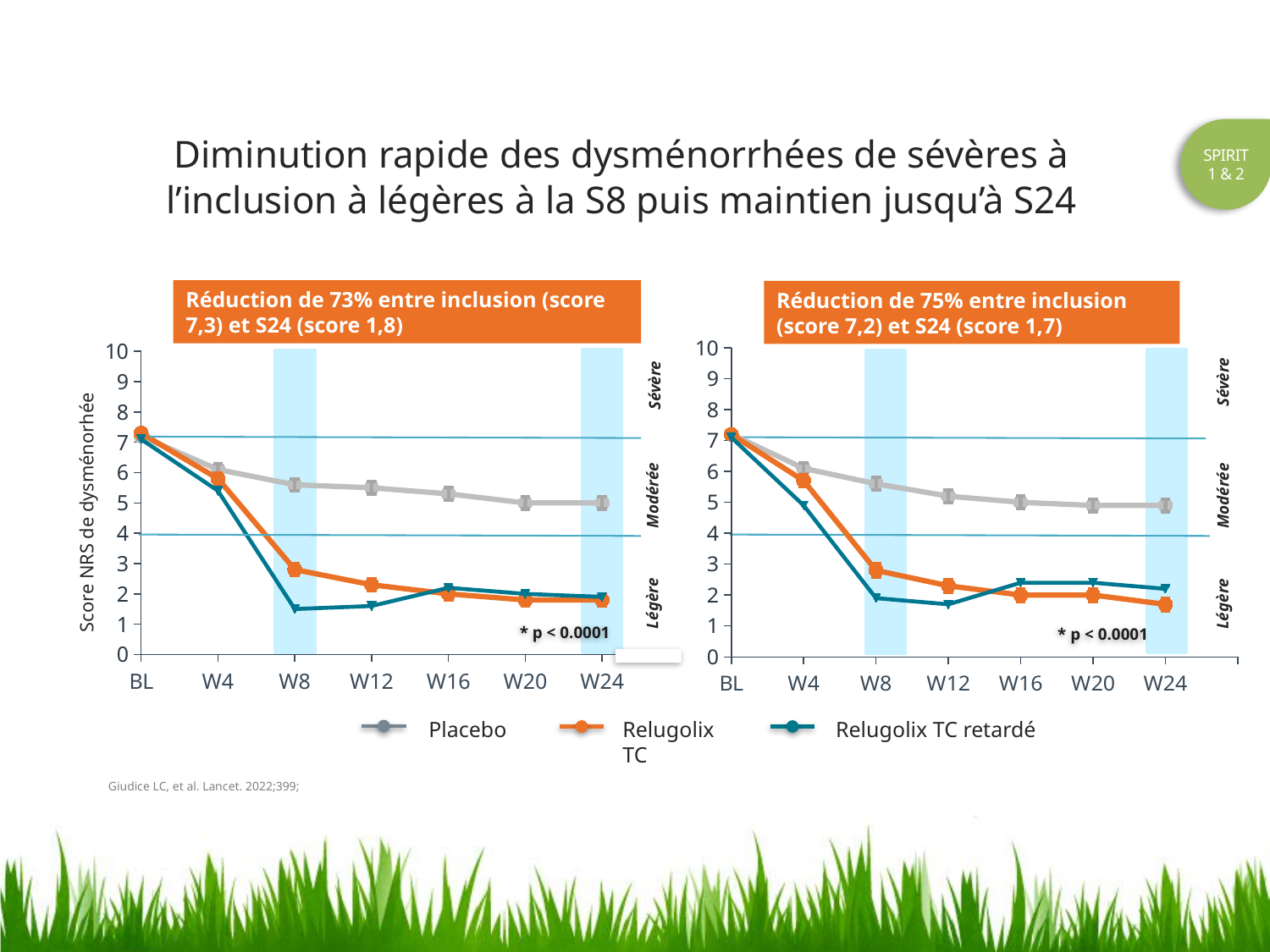
In the right chart, which series has the highest value at W24? Placebo In the left chart, what score at inclusion is stated in the orange banner? 7,3 In the right chart, does the Placebo series rise or fall from BL to W24? fall In the left chart, is the Placebo value at W8 greater or less than 5? greater In the left chart, what score at S24 is stated in the orange banner? 1,8 What kind of chart is the left chart on the slide? line chart How many series does the legend list for the charts? 3 In the right chart, what is the difference between the inclusion score (7,2) and the S24 score (1,7) stated in the banner? 5,5 In the right chart, what percentage reduction between inclusion and S24 is stated in the orange banner? 75% In the left chart, which series has the lowest value at W8? Relugolix TC retardé How many time points are shown on the x axis of the left chart? 7 In the left chart, is the Relugolix TC value at W8 greater or less than 4? less